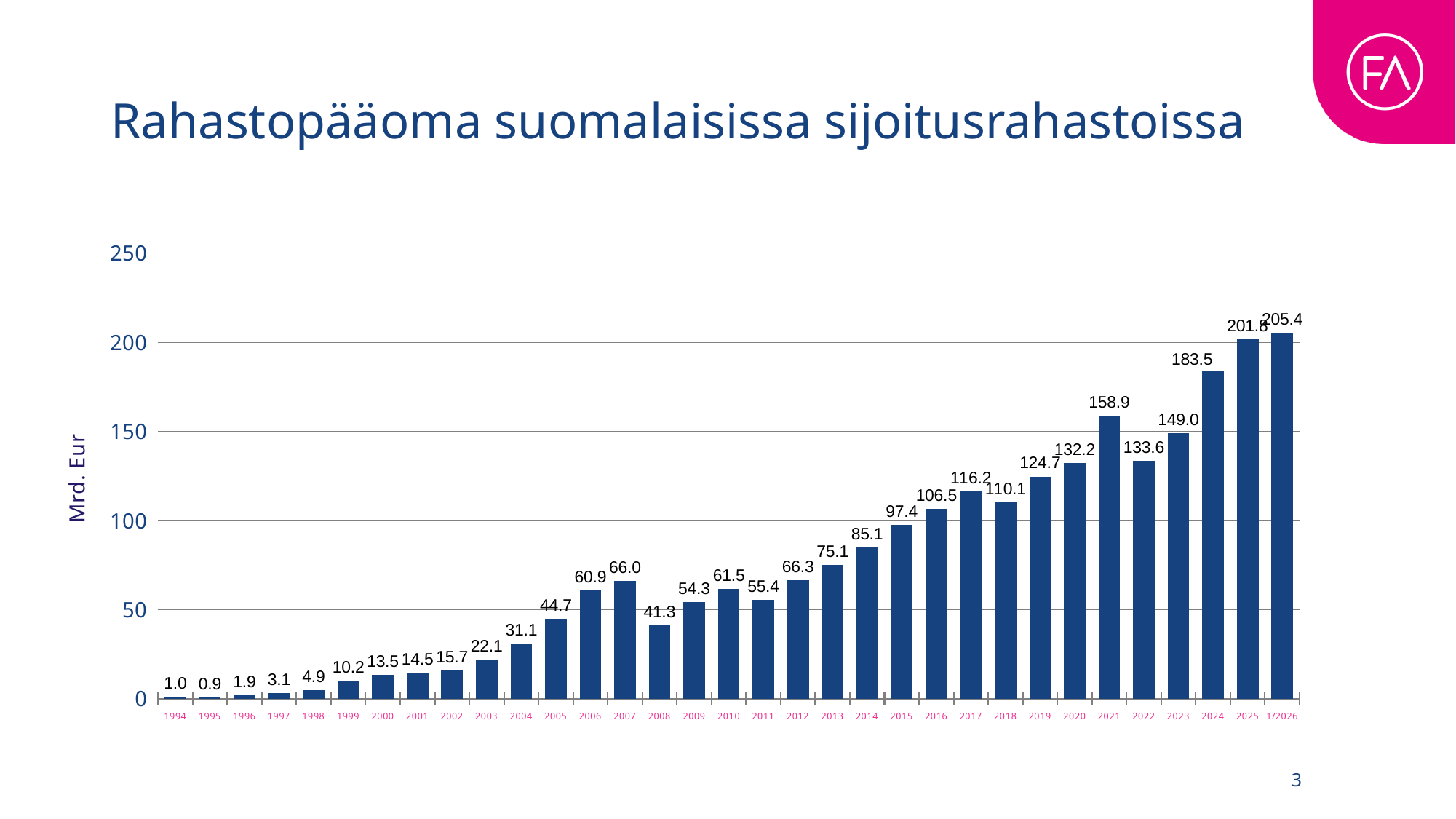
What is the value for 2008? 41.3 What is the difference between the values for 2025 and 2024? 18.3 What is the value for 2021? 158.9 How many bars are shown in the chart? 33 Is the value for 2024 greater or less than 150? greater What kind of chart is shown on the slide? bar chart What is the label on the vertical axis? Mrd. Eur What is the difference between the values for 2021 and 2022? 25.3 What is the value for 1/2026? 205.4 Which is larger, the value for 2007 or the value for 2008? 2007 Which year has the highest value? 1/2026 Which year has the lowest value? 1995